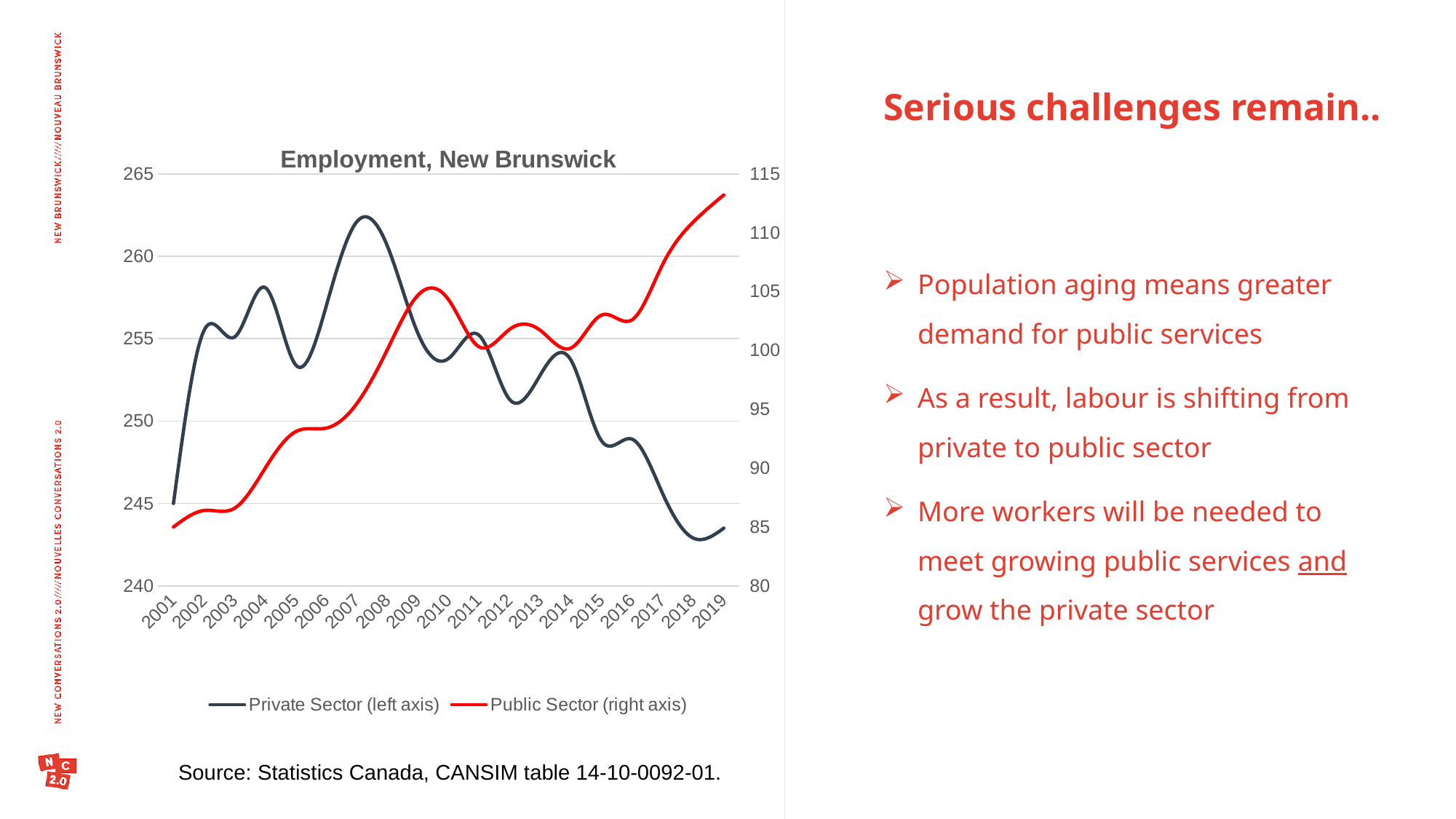
How many series does the chart's legend list? 2 In which year does the Public Sector series reach its highest value? 2019 Is the Public Sector value for 2001 greater or less than 90? less What kind of chart is shown on the slide? line chart In which year does the Private Sector series reach its highest value? 2007 Which axis does the Public Sector series use, according to the legend? right axis In which year does the Public Sector series have its lowest value? 2001 How many years are plotted along the x axis of the chart? 19 Is the Private Sector value for 2007 greater or less than 260? greater Does the Public Sector series generally rise or fall from 2001 to 2019? rise What is the title of the chart? Employment, New Brunswick Is the Public Sector value for 2019 greater or less than 110? greater